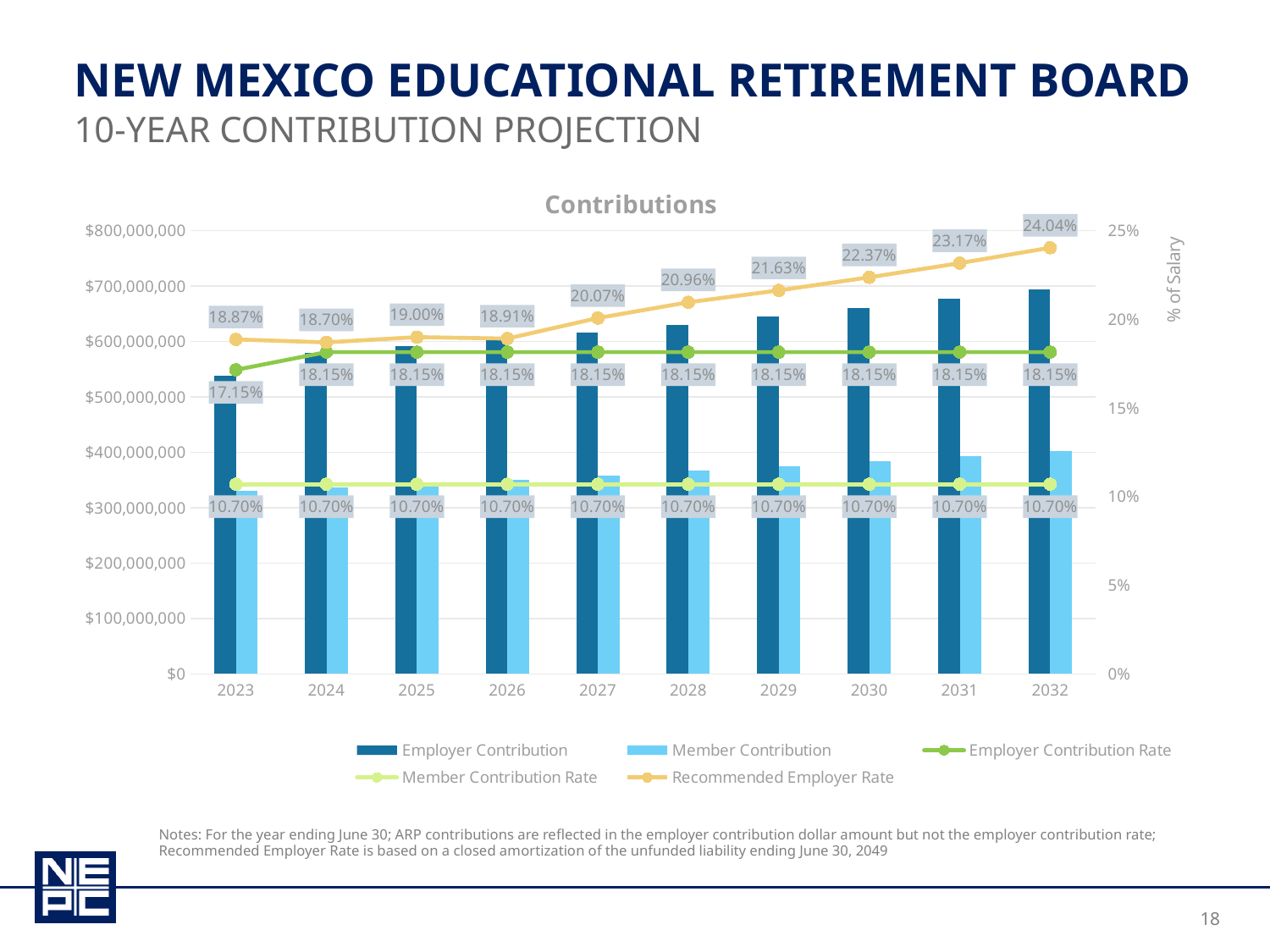
What is the Recommended Employer Rate for 2032? 24.04% What is the Member Contribution Rate for 2028? 10.70% Is the Member Contribution for 2023 greater or less than $400,000,000? less What is the Employer Contribution Rate for 2023? 17.15% How many series does the chart's legend list? 5 How many years are shown on the x axis of the chart? 10 Does the Recommended Employer Rate rise or fall from 2027 to 2032? rise Which year has the higher Recommended Employer Rate, 2025 or 2026? 2025 Is the Employer Contribution for 2032 greater or less than $600,000,000? greater In which year is the Recommended Employer Rate lowest? 2024 In which year is the Recommended Employer Rate highest? 2032 By how many percentage points does the Recommended Employer Rate in 2032 exceed the rate in 2023? 5.17 percentage points